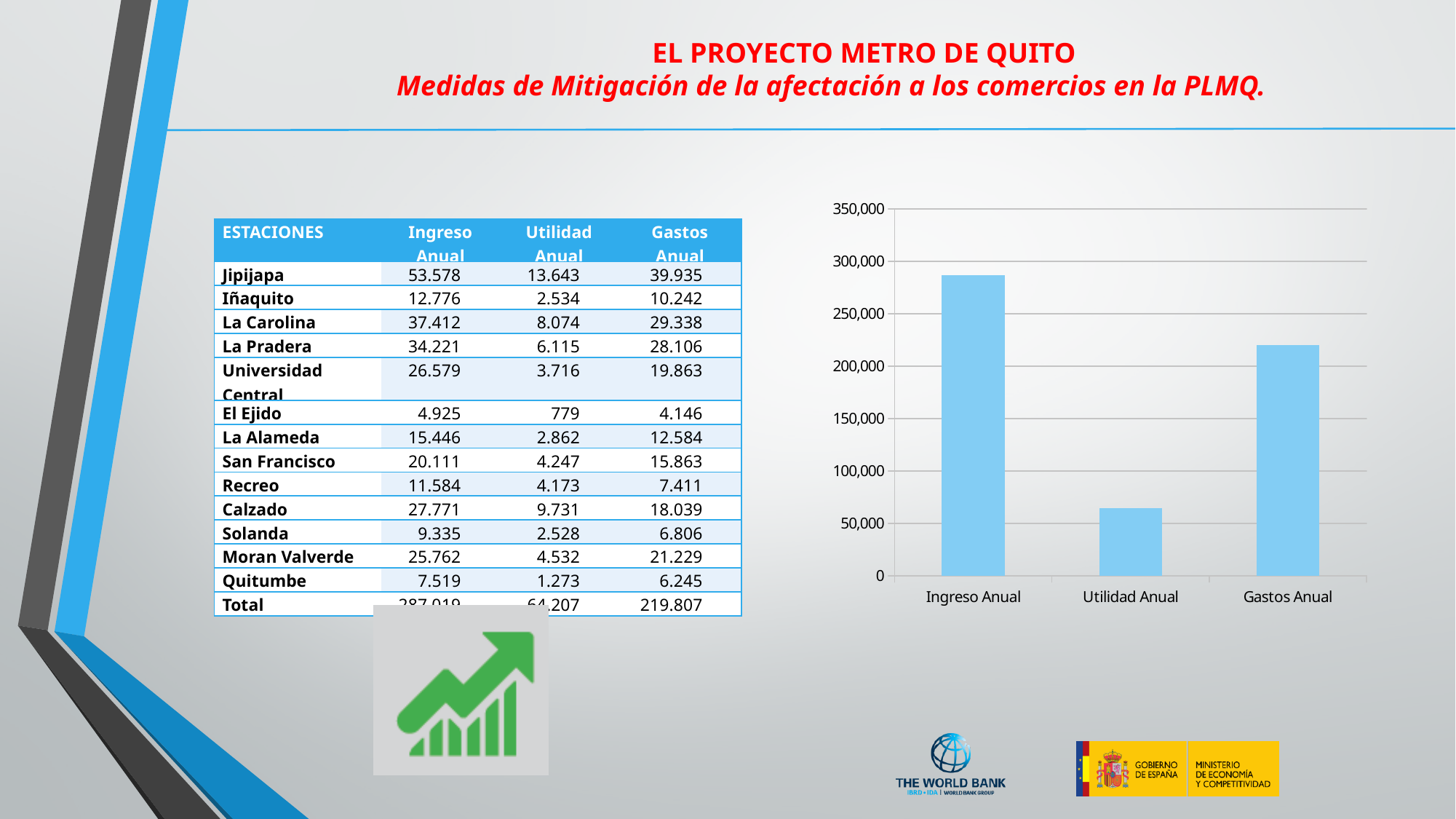
Which category has the lowest bar in the chart? Utilidad Anual Is the value for Gastos Anual greater or less than 200,000? greater What kind of chart is shown on the slide? bar chart What colour are the bars in the chart? light blue Which is larger, the bar for Ingreso Anual or the bar for Gastos Anual? Ingreso Anual What is the highest value shown on the chart's vertical axis? 350,000 How many bars does the chart show? 3 Is the value for Ingreso Anual greater or less than 250,000? greater Is the value for Ingreso Anual greater or less than 300,000? less Which is larger, the bar for Gastos Anual or the bar for Utilidad Anual? Gastos Anual Which category has the highest bar in the chart? Ingreso Anual